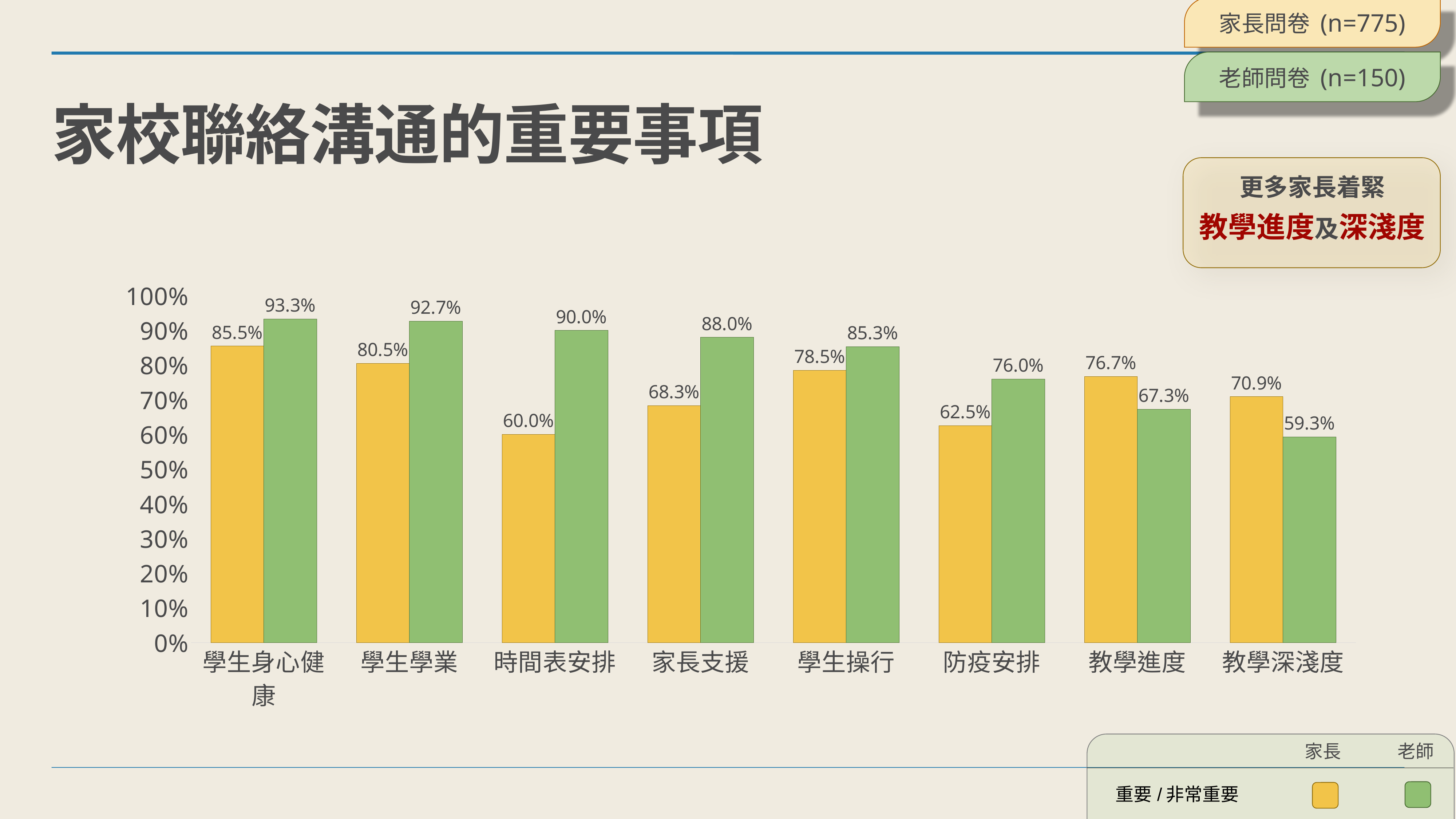
Which category has the lowest 家長 value? 時間表安排 What is the 家長 value for 教學深淺度? 70.9% What kind of chart is shown on the slide? bar chart What is the 家長 value for 學生身心健康? 85.5% Which category has the highest 老師 value? 學生身心健康 How many categories are shown on the x axis? 8 What is the 老師 value for 時間表安排? 90.0% How many series does the legend list? 2 Is the 老師 value for 防疫安排 greater or less than 70%? greater What is the difference between the 老師 and 家長 values for 時間表安排? 30.0% For 教學進度, which is larger: the 家長 value or the 老師 value? 家長 What colour represents the 老師 series? green